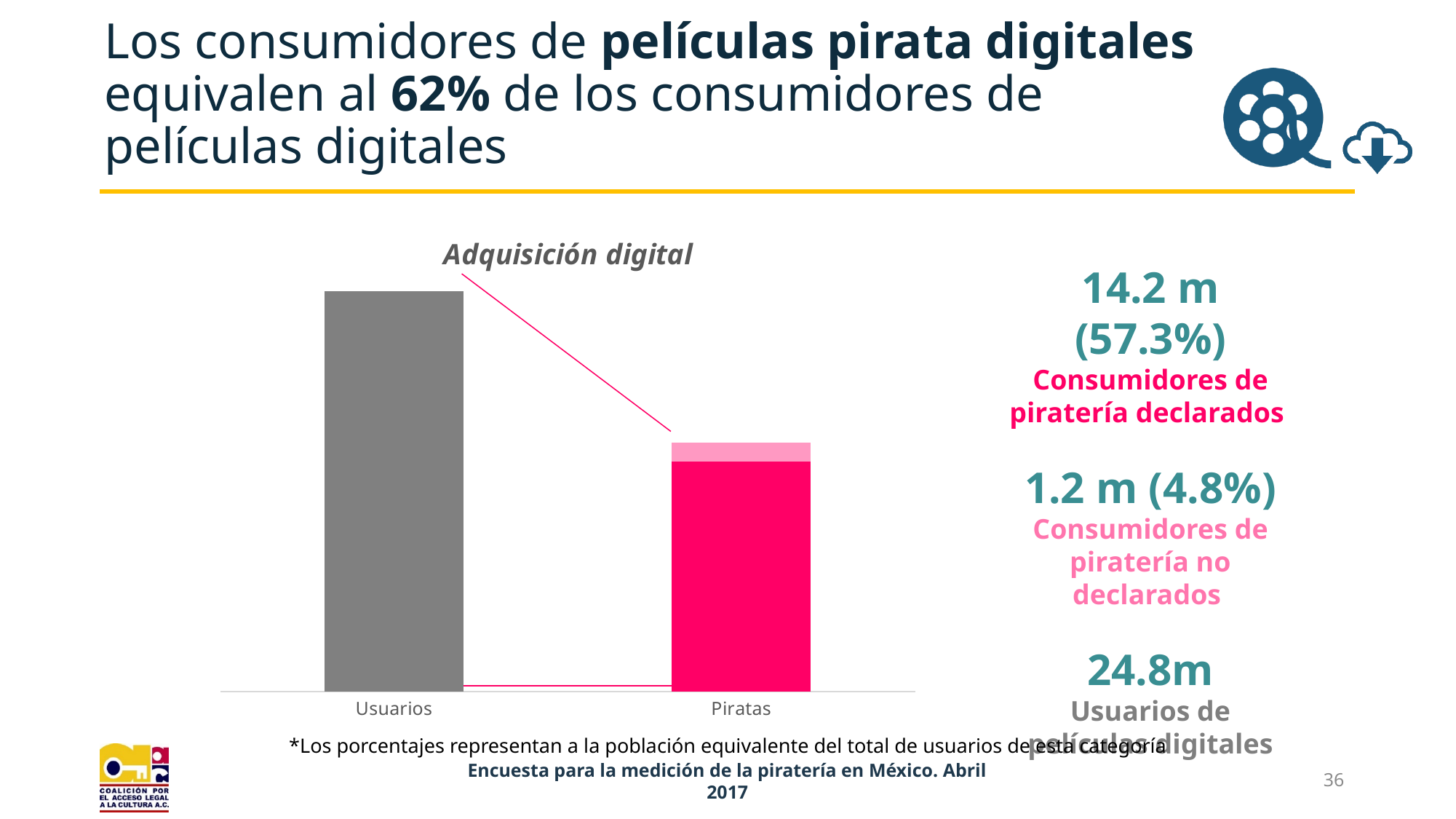
What are the two category labels on the x axis of the chart? Usuarios and Piratas What colour is the Usuarios bar in the chart? grey According to the slide title, digital pirate film consumers equal what percentage of digital film consumers? 62% What is the total of the stacked Piratas bar, adding declared and undeclared pirate consumers in millions? 15.4 m What value is given for Consumidores de piratería no declarados? 1.2 m (4.8%) How many categories are shown on the x axis of the "Adquisición digital" chart? 2 What is the number of Usuarios de películas digitales shown on the slide? 24.8m Which category has the lowest bar in the chart? Piratas What kind of chart is shown under the title "Adquisición digital"? bar chart What value is given for Consumidores de piratería declarados? 14.2 m (57.3%) Which category has the taller bar, Usuarios or Piratas? Usuarios What is the difference in millions between Usuarios (24.8m) and Consumidores de piratería declarados (14.2 m)? 10.6 m